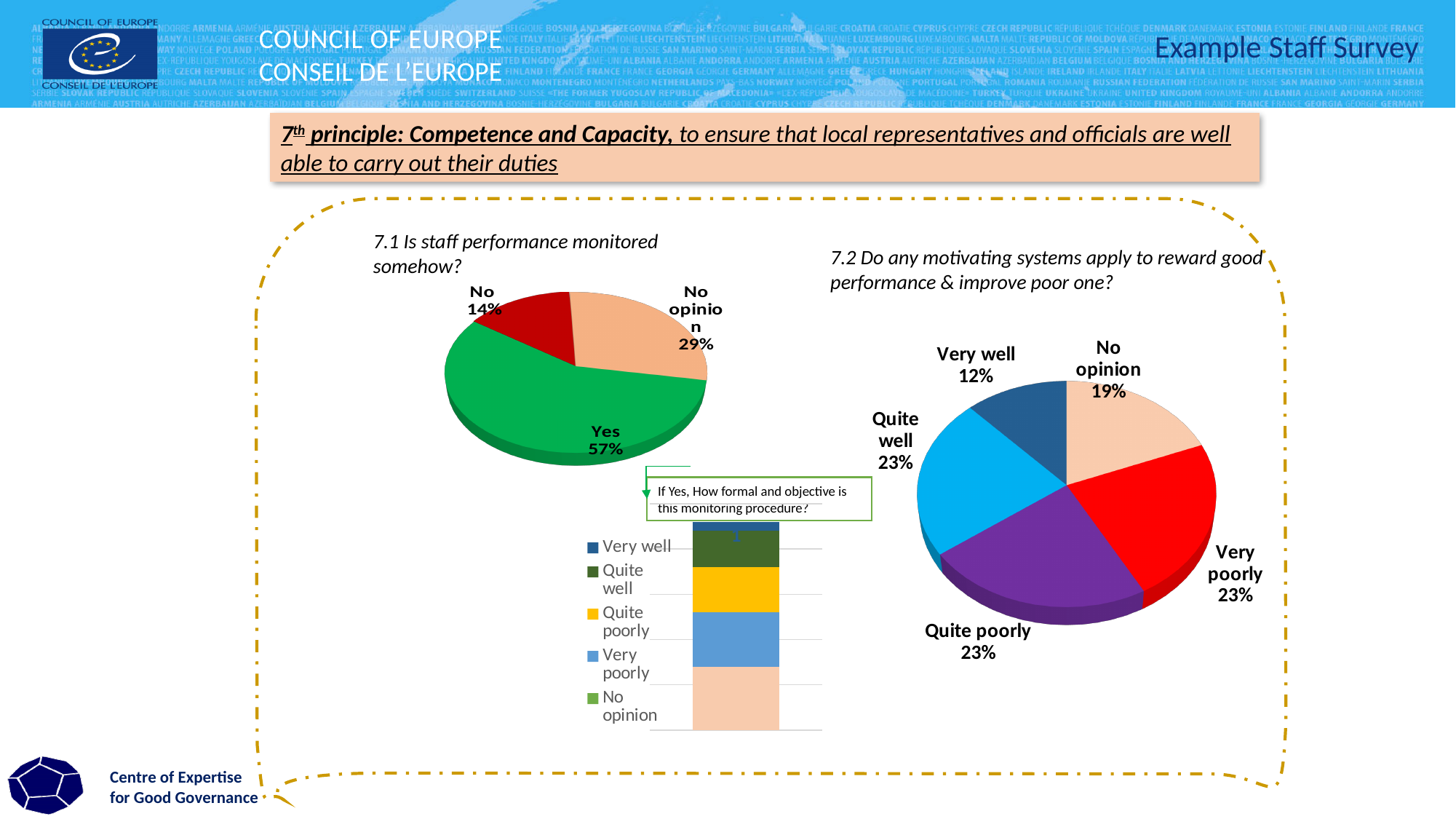
In the 7.1 pie chart (Is staff performance monitored somehow?), which answer has the smallest share? No What kind of chart is the one titled 'If Yes, How formal and objective is this monitoring procedure?'? Stacked bar chart In the 7.2 pie chart (Do any motivating systems apply to reward good performance & improve poor one?), what share answered No opinion? 19% In the 7.1 pie chart (Is staff performance monitored somehow?), what share answered Yes? 57% In the 7.1 pie chart (Is staff performance monitored somehow?), how many percentage points larger is Yes than No opinion? 28 In the 7.2 pie chart (Do any motivating systems apply to reward good performance & improve poor one?), what share answered Very well? 12% In the 7.1 pie chart (Is staff performance monitored somehow?), how many slices are there? 3 In the 7.2 pie chart (Do any motivating systems apply to reward good performance & improve poor one?), which is larger: No opinion or Quite poorly? Quite poorly In the 7.2 pie chart (Do any motivating systems apply to reward good performance & improve poor one?), how many slices are there? 5 In the 7.1 pie chart (Is staff performance monitored somehow?), what share answered No? 14% In the 7.2 pie chart (Do any motivating systems apply to reward good performance & improve poor one?), which answer has the smallest share? Very well In the 7.1 pie chart (Is staff performance monitored somehow?), which answer has the largest share? Yes